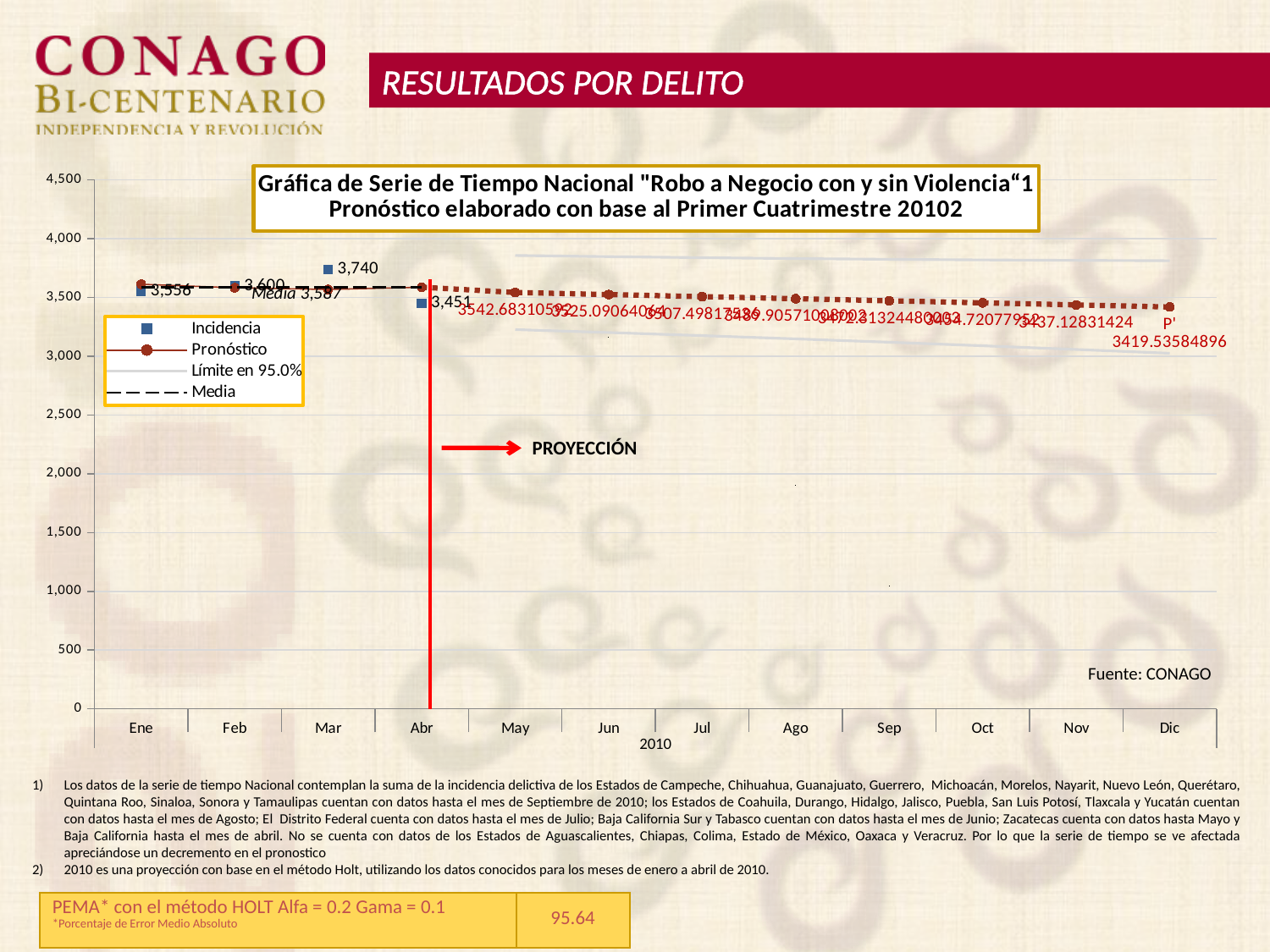
What is the Incidencia value for Abr? 3,451 What kind of chart is shown on the slide? line chart How many months are shown on the x axis? 12 Which month has the highest Incidencia value? Mar What is the Pronóstico value for Dic? 3419.53584896 Which is larger, the Incidencia value for Ene or for Feb? Feb What is the value of the Media line shown on the chart? 3,587 What is the difference between the Incidencia values for Mar and Abr? 289 What is the Incidencia value for Mar? 3,740 How many series does the legend list? 4 Does the Pronóstico series rise or fall from May to Dic? fall